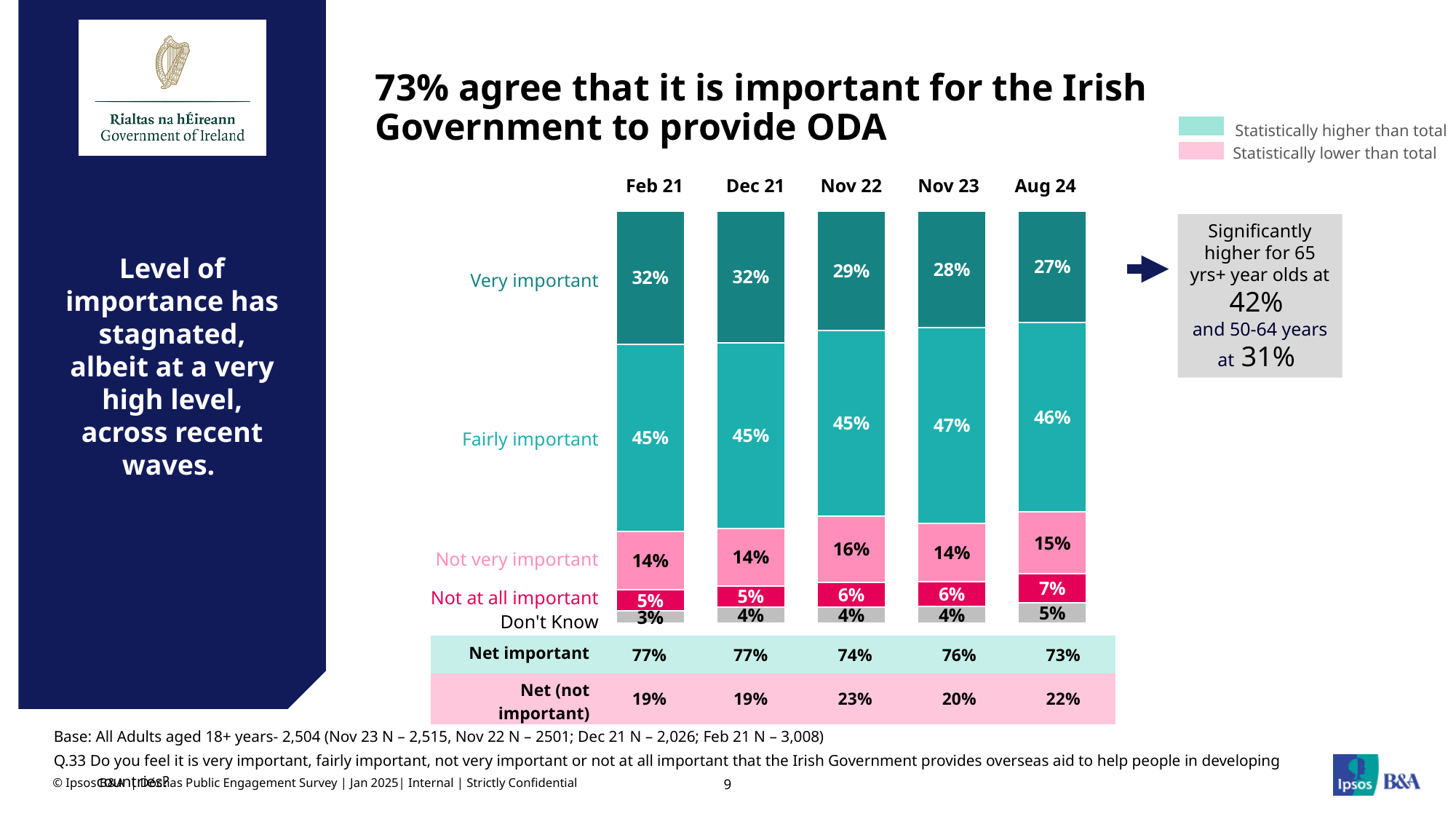
What is the difference between the 'Very important' share in Feb 21 and Aug 24? 5 percentage points In which wave is the 'Not at all important' share highest? Aug 24 Does the 'Very important' share rise or fall from Feb 21 to Aug 24? Fall Which is larger: 'Fairly important' in Nov 23 or 'Fairly important' in Aug 24? Nov 23 What percentage said 'Very important' in Aug 24? 27% How many survey waves are shown on the chart? 5 In which wave is the 'Very important' share highest? Feb 21 and Dec 21 (32%) What percentage said 'Not very important' in Nov 22? 16% What percentage said 'Fairly important' in Nov 23? 47% How many response categories are stacked in each bar? 5 What type of chart is shown? Stacked bar chart What is the 'Don't Know' value for Feb 21? 3%